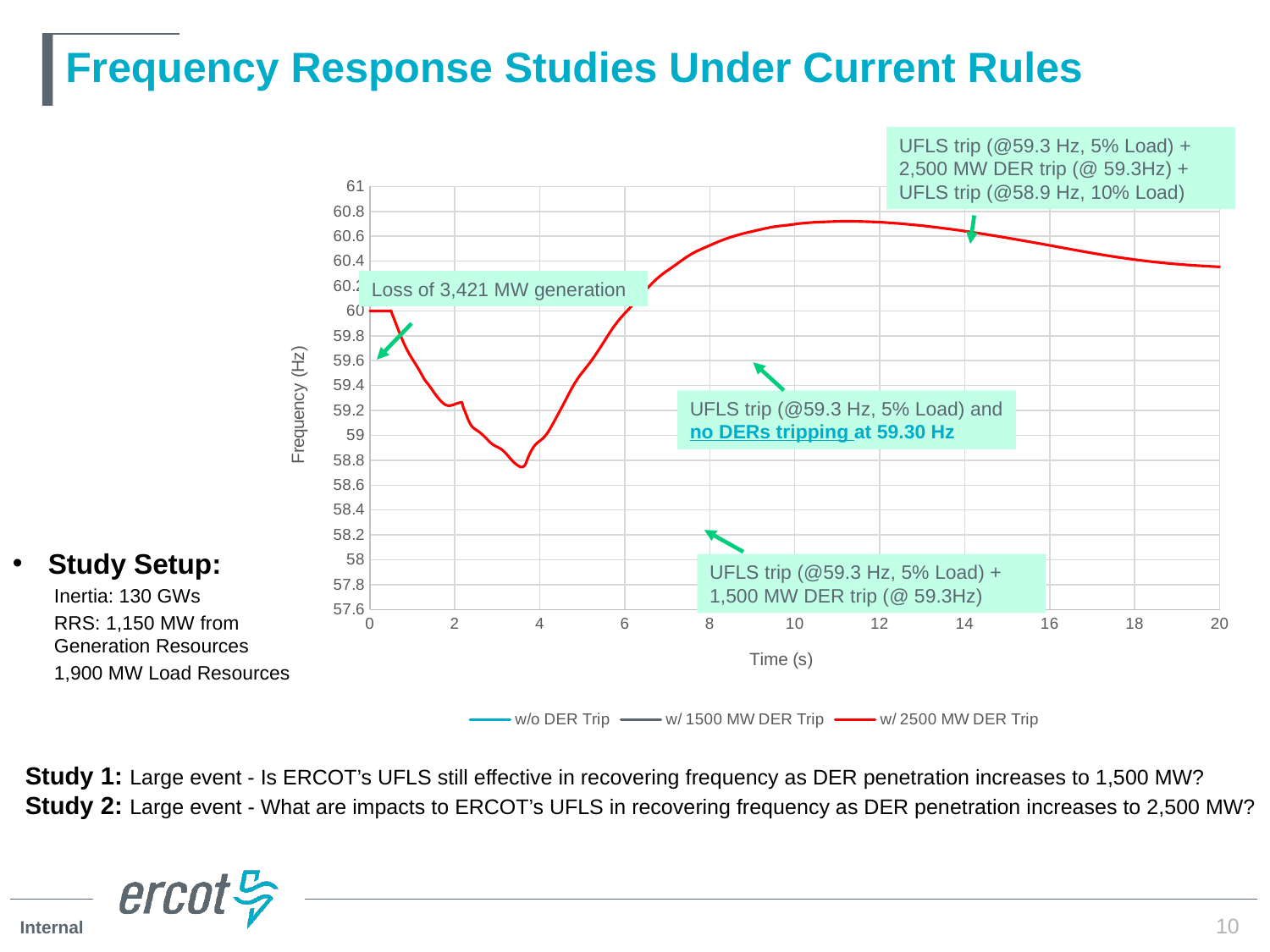
Is the lowest value reached by the red line greater or less than 59? less Is the value of the red line at 20 s greater or less than 60.6? less Which series in the legend is drawn in red? w/ 2500 MW DER Trip Between 4 s and 10 s, does the red line rise or fall? rise Between 0 s and 3 s, does the red line rise or fall? fall How many series does the chart legend list? 3 Is the value of the red line at 2 s greater or less than 59.6? less What is the label of the y-axis of the chart? Frequency (Hz) What is the frequency value of the red line at time 0 s? 60 Which is larger for the red line: the value at 10 s or the value at 4 s? the value at 10 s What kind of chart is shown on the slide? line chart